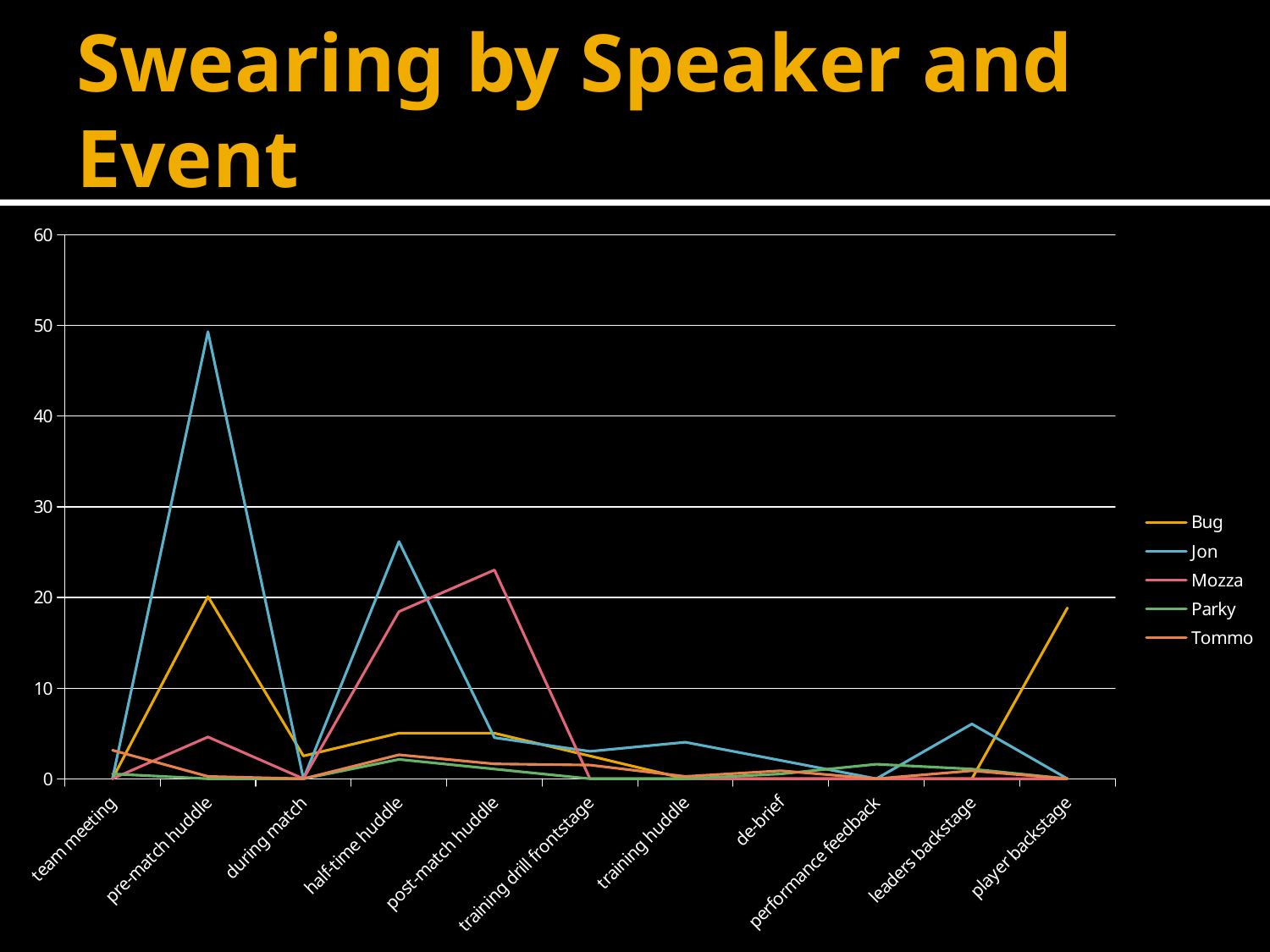
Which speaker has the highest value anywhere on the chart? Jon Which speaker has the higher value at the pre-match huddle, Jon or Bug? Jon What kind of chart is shown on the slide? line chart Is Mozza's value at the post-match huddle greater or less than 20? greater What is the title of the chart? Swearing by Speaker and Event Is Jon's value at the half-time huddle greater or less than 20? greater At which event does Jon reach his highest value? pre-match huddle How many event categories are shown along the x axis? 11 How many series does the legend list? 5 Does Mozza's line rise or fall from the post-match huddle to training drill frontstage? fall Which speaker has the highest value at the player backstage event? Bug Is Jon's value at the pre-match huddle greater or less than 40? greater